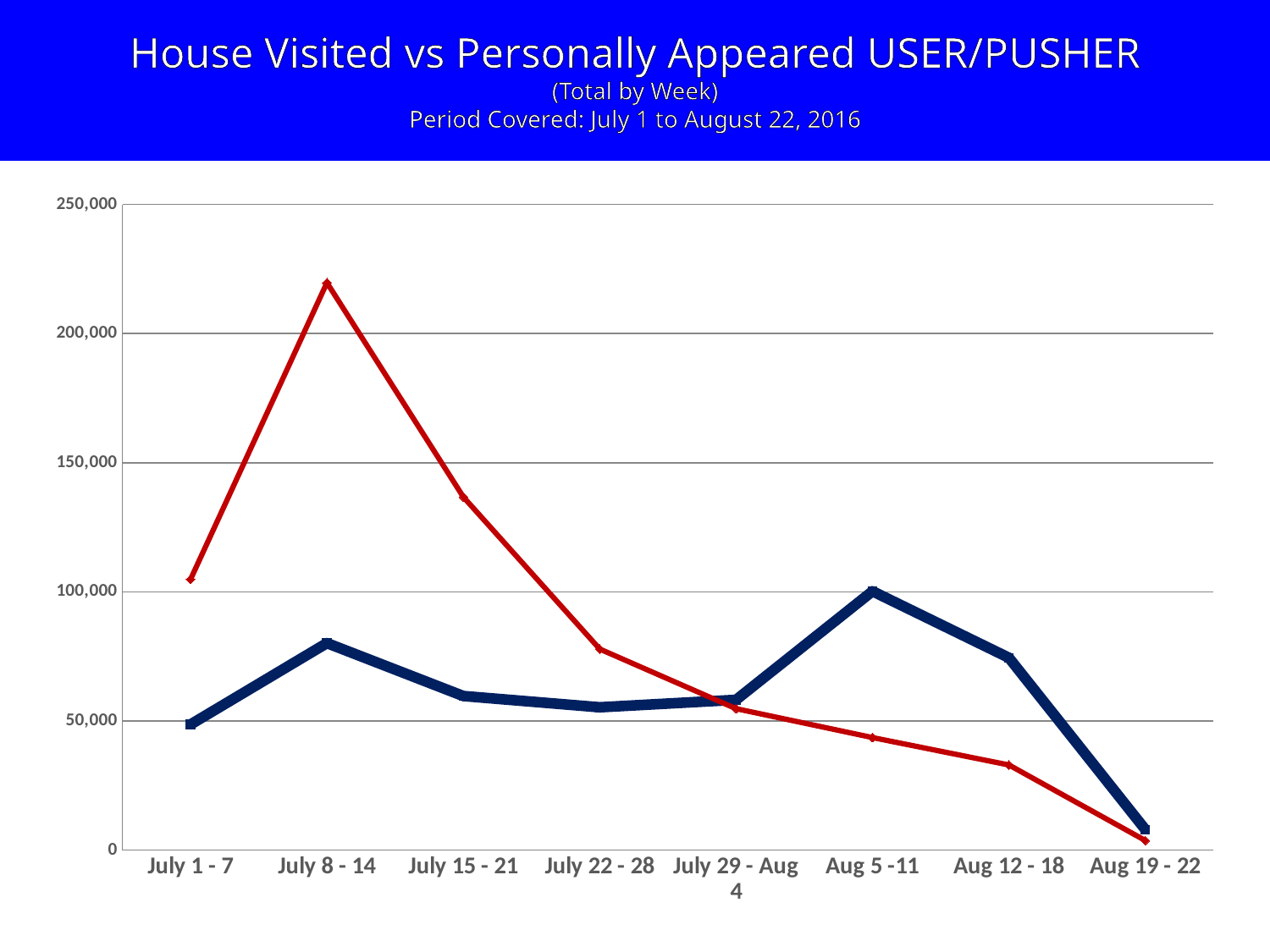
Is the value of the red line for July 8 - 14 greater or less than 200,000? greater What period does the chart cover, according to the title? July 1 to August 22, 2016 In which week does the dark blue line reach its highest value? Aug 5 -11 In which week does the red line reach its lowest value? Aug 19 - 22 Is the value of the red line for July 15 - 21 greater or less than 150,000? less What kind of chart is shown on the slide? Line chart Does the red line rise or fall from July 8 - 14 through Aug 19 - 22? Fall Is the value of the dark blue line for Aug 19 - 22 greater or less than 50,000? less How many weekly periods are plotted along the x axis? 8 For the week Aug 5 -11, which line has the larger value, the red line or the dark blue line? The dark blue line In which week does the red line reach its highest value? July 8 - 14